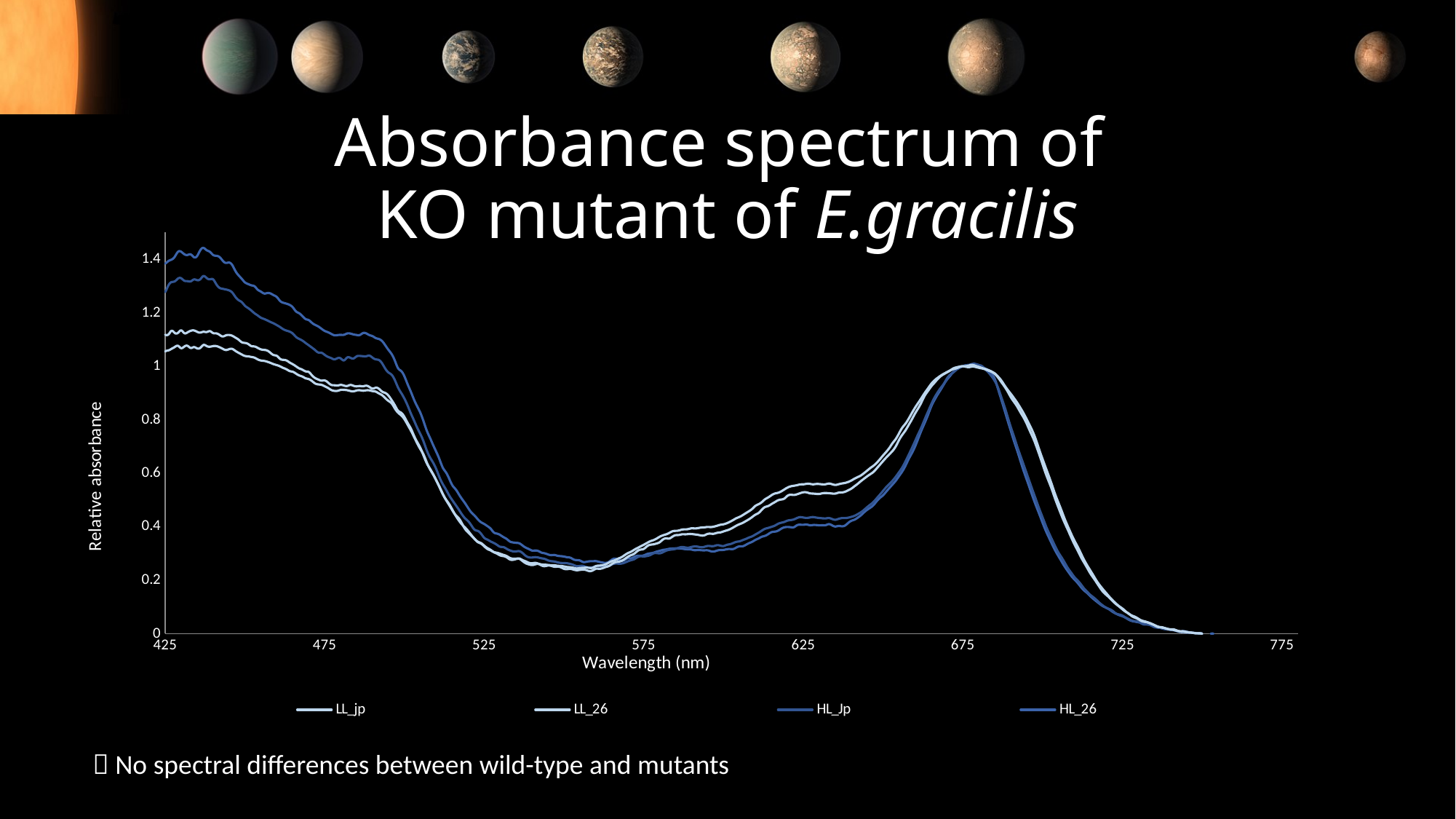
What is the title of the chart? Absorbance spectrum of KO mutant of E.gracilis Near which labelled wavelength tick do all series reach their maximum relative absorbance? 675 At 425 nm, which group of series has the higher relative absorbance, the HL series or the LL series? HL Do the values rise or fall along the x axis between 500 nm and 550 nm? fall How many series does the legend list? 4 What is the label of the x axis? Wavelength (nm) Is the relative absorbance of the HL_26 series at 425 nm greater or less than 1.2? greater Is the relative absorbance of the series at 725 nm greater or less than 0.2? less Is the relative absorbance of the LL_jp series at 625 nm greater or less than 0.4? greater Do the values rise or fall along the x axis between 625 nm and 675 nm? rise What kind of chart is shown on the slide? line chart